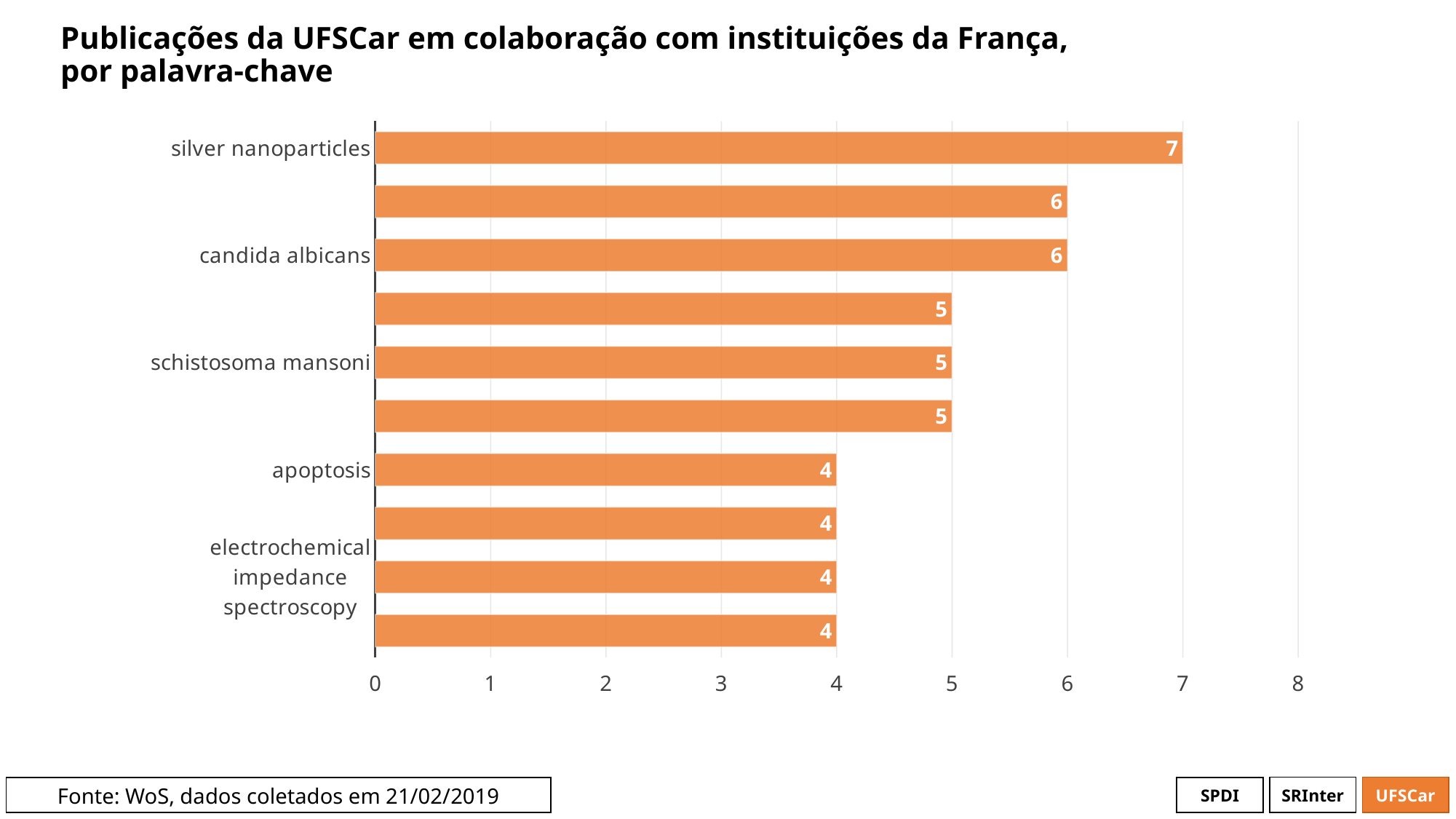
How many bars are plotted in the chart? 10 What is the value for "candida albicans"? 6 What is the title of the chart? Publicações da UFSCar em colaboração com instituições da França, por palavra-chave How many publications are shown for the keyword "silver nanoparticles"? 7 What is the difference between the values for "silver nanoparticles" and "apoptosis"? 3 What kind of chart is shown on the slide? bar chart What is the value for "apoptosis"? 4 What is the difference between the values for "candida albicans" and "schistosoma mansoni"? 1 What is the value for "electrochemical impedance spectroscopy"? 4 Which has a larger value, "candida albicans" or "schistosoma mansoni"? candida albicans Which keyword has the highest number of publications? silver nanoparticles What is the value for "schistosoma mansoni"? 5